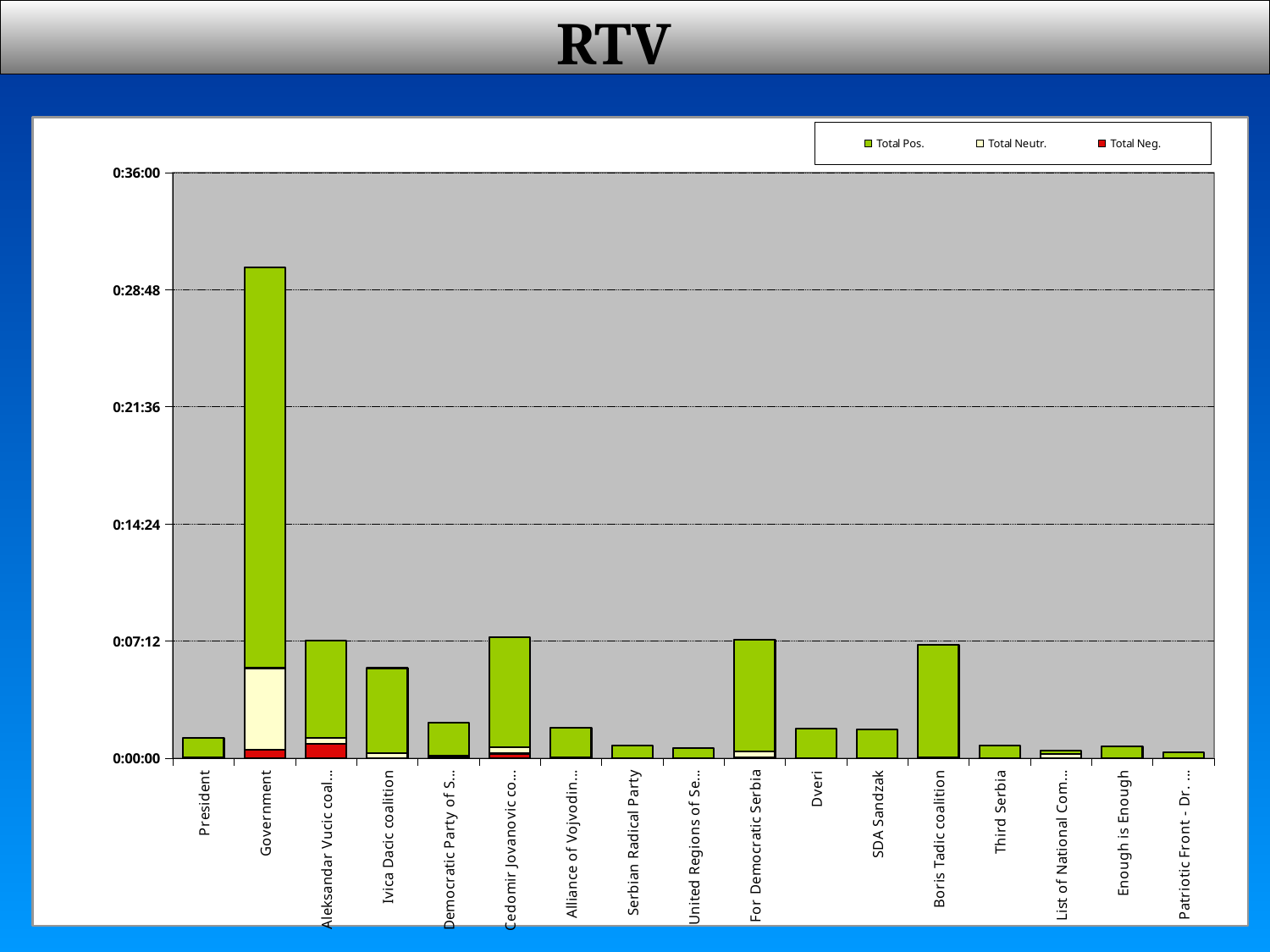
Is the total value for Ivica Dacic coalition greater or less than 0:07:12? less What are the three series named in the legend? Total Pos., Total Neutr., Total Neg. Which bar is taller, Government or Boris Tadic coalition? Government Is the total value for Government greater or less than 0:28:48? greater Is the total value for Dveri greater or less than 0:07:12? less How many categories are shown on the x axis? 17 What colour represents Total Neg. in the chart? Red What kind of chart is shown on the slide? Stacked bar chart Which category has the tallest bar? Government Which category has the largest Total Neutr. segment? Government Which bar is taller, Ivica Dacic coalition or Dveri? Ivica Dacic coalition How many series does the legend list? 3